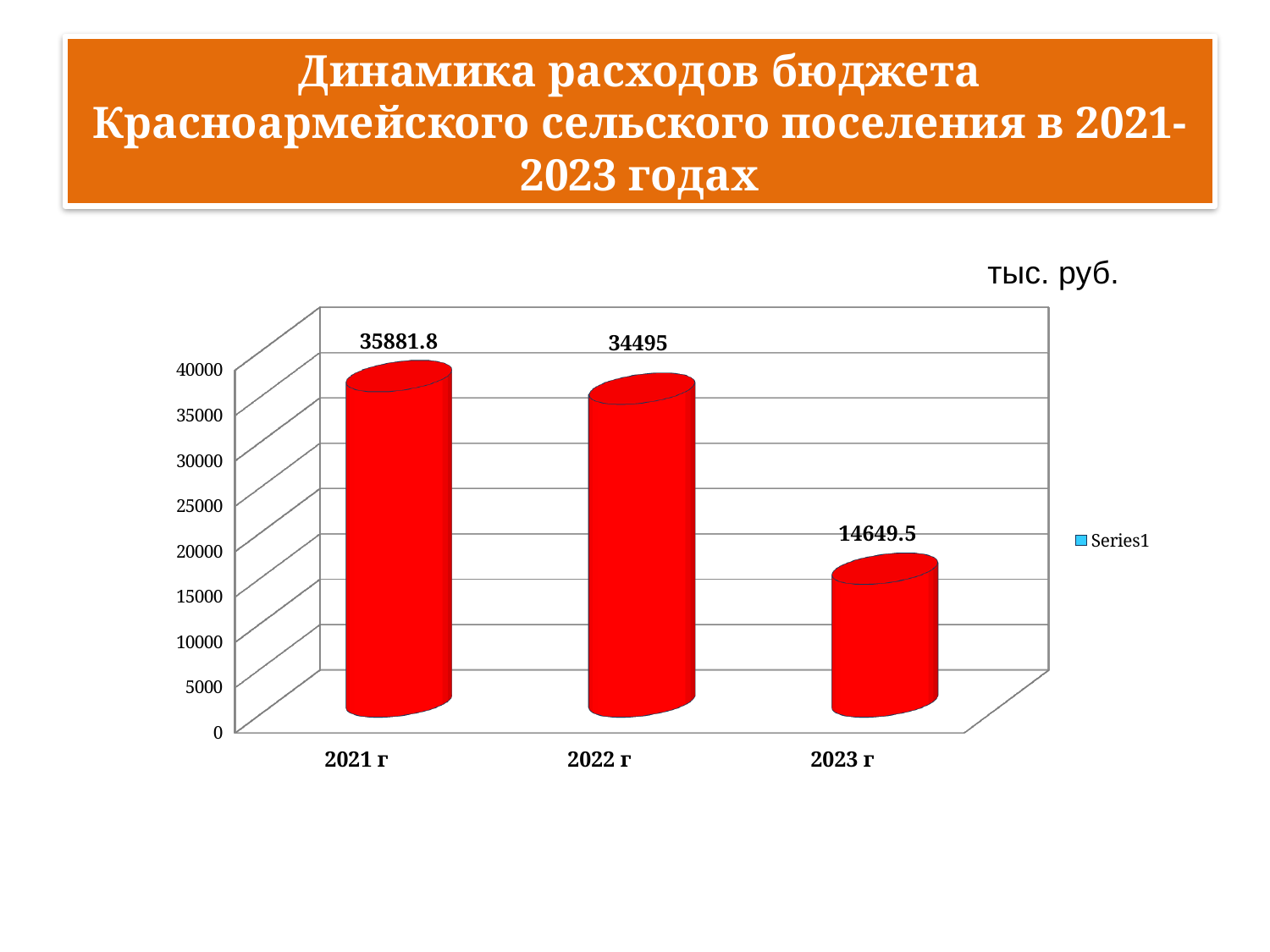
What kind of chart is shown on the slide? bar chart What is the value for 2021 г? 35881.8 What is the value for 2023 г? 14649.5 Is the value for 2023 г greater or less than 20000? less How many years are shown on the chart? 3 Which is larger, the value for 2022 г or the value for 2023 г? 2022 г Which year has the highest value? 2021 г What is the value for 2022 г? 34495 What is the difference between the values for 2022 г and 2023 г? 19845.5 What is the difference between the values for 2021 г and 2022 г? 1386.8 Do the values rise or fall from 2021 г to 2023 г? fall Which year has the lowest value? 2023 г